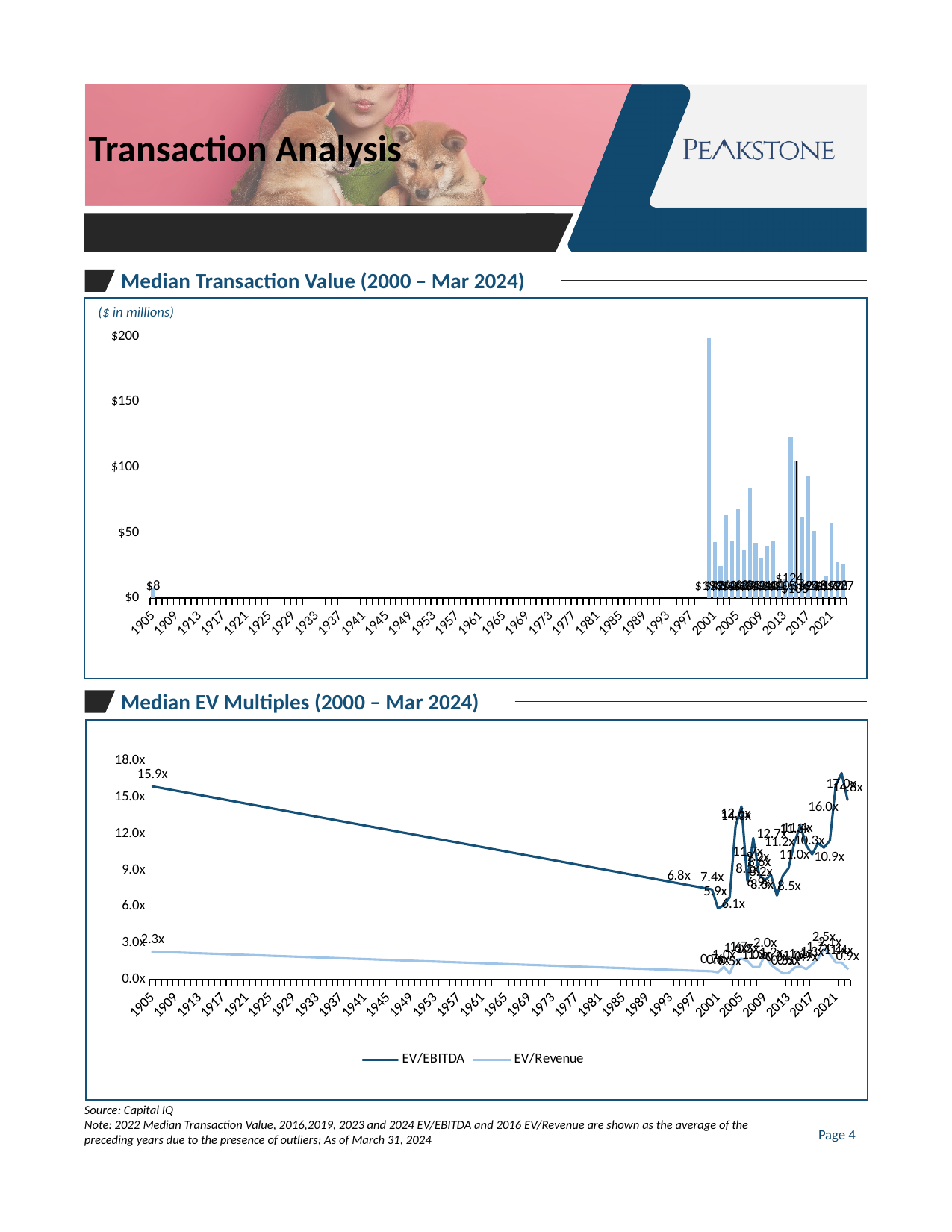
How many series does the legend of the Median EV Multiples chart list? 2 In the Median Transaction Value chart, is the tallest bar greater or less than $150? greater In the Median EV Multiples chart, does the EV/EBITDA line rise or fall from 1905 to the late 1990s? fall In the Median EV Multiples chart, what is the EV/EBITDA value labeled at 1905? 15.9x In the Median Transaction Value chart, what unit note is shown above the y-axis? ($ in millions) In the Median EV Multiples chart, which series is higher at 1905, EV/EBITDA or EV/Revenue? EV/EBITDA What kind of chart is the Median Transaction Value (2000 – Mar 2024) chart? bar chart What kind of chart is the Median EV Multiples (2000 – Mar 2024) chart? line chart In the Median EV Multiples chart, what is the difference between the EV/EBITDA and EV/Revenue values at 1905? 13.6x In the Median EV Multiples chart, what is the EV/Revenue value labeled at 1905? 2.3x In the Median Transaction Value chart, what is the value labeled for 1905? $8 What are the two series named in the legend of the Median EV Multiples chart? EV/EBITDA and EV/Revenue